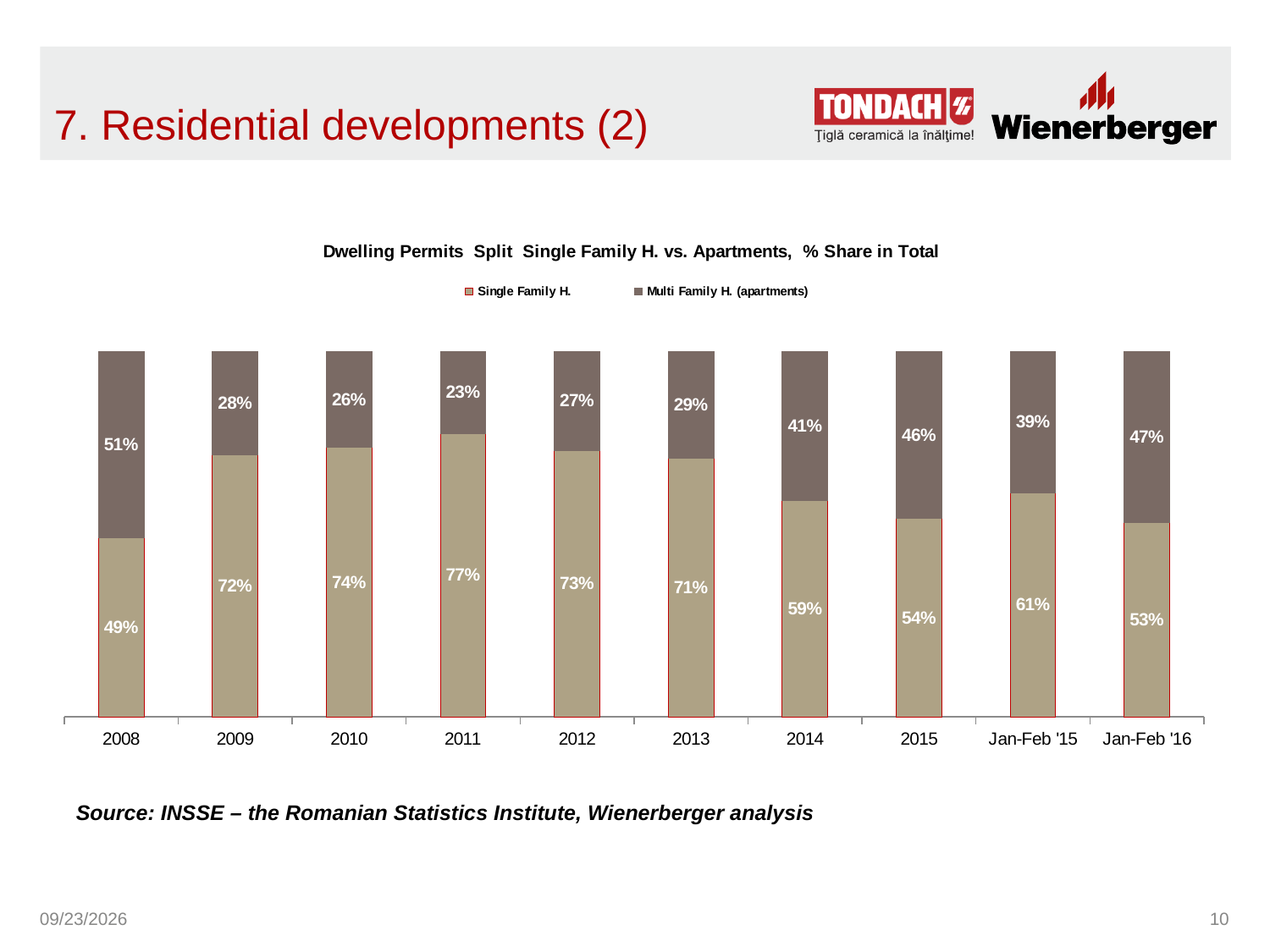
What is the Single Family H. share in 2011? 77% How many categories are shown on the x axis? 10 What is the Multi Family H. (apartments) share in 2015? 46% What is the Single Family H. share for Jan-Feb '16? 53% Which category has the highest Single Family H. share? 2011 What is the difference between the Single Family H. share in 2011 and in 2015? 23% Which category has the highest Multi Family H. (apartments) share? 2008 What kind of chart is shown on the slide? Stacked bar chart Which category has the lowest Single Family H. share? 2008 What is the title of the chart? Dwelling Permits Split Single Family H. vs. Apartments, % Share in Total Is the Single Family H. share larger in 2014 or in Jan-Feb '15? Jan-Feb '15 How many series does the legend list? 2